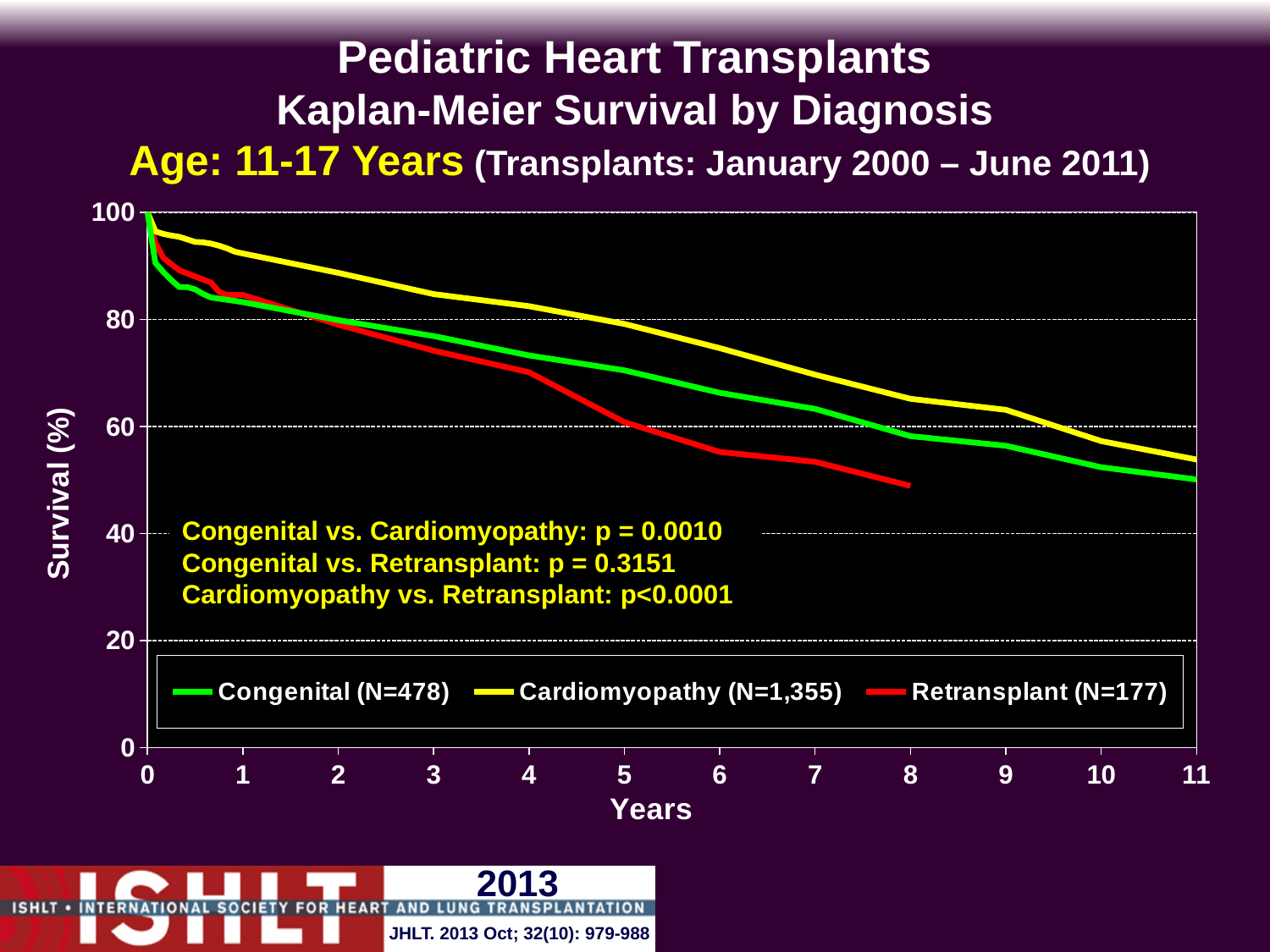
Is the survival value for Cardiomyopathy at 8 years greater or less than 60? greater Is the survival value for Retransplant at 8 years greater or less than 60? less Is the survival value for Congenital at 11 years greater or less than 60? less How many series does the legend list? 3 What is the N for the Cardiomyopathy series in the legend? 1,355 At 6 years, which series has higher survival, Congenital or Retransplant? Congenital What kind of chart is shown on the slide? Line chart Which series has the highest survival at 10 years? Cardiomyopathy Which series has the lowest survival at 7 years? Retransplant At 8 years, which series has higher survival, Cardiomyopathy or Congenital? Cardiomyopathy Do the survival curves rise or fall as years increase? Fall